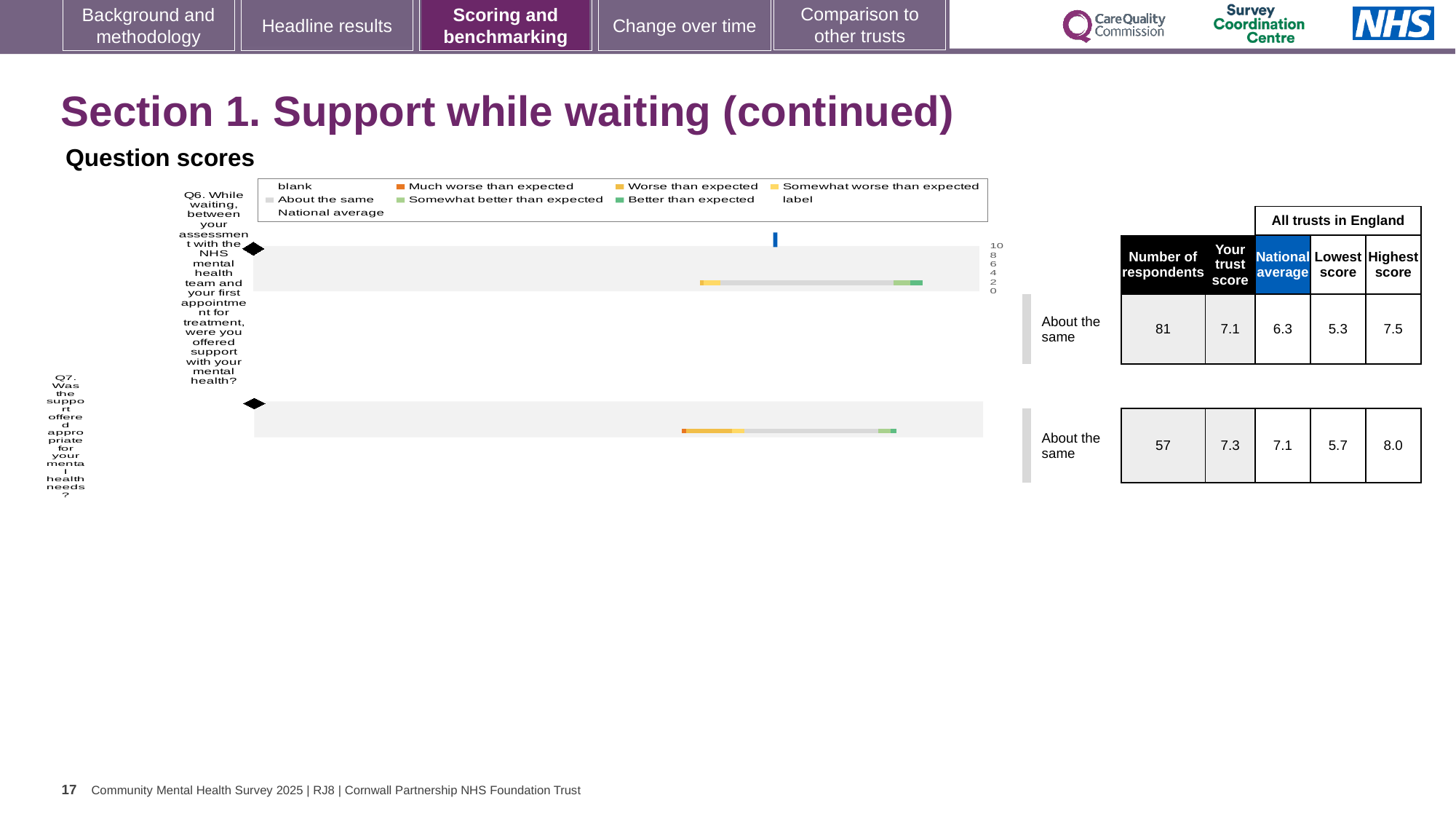
What is the national average score for Q7 (was the support offered appropriate for your mental health needs)? 7.1 How many respondents are recorded for Q6? 81 How many questions are plotted in the question scores chart? 2 What colour does the legend use for 'Much worse than expected'? Orange What kind of chart is used to show the question scores on this slide? Bar chart What is the lowest score among all trusts in England for Q7? 5.7 Which question has more respondents, Q6 or Q7? Q6 What benchmark category label is shown next to the Q6 bar? About the same What is the 'Your trust score' value for Q6 (support with your mental health while waiting)? 7.1 What is the highest score among all trusts in England for Q7? 8.0 Which question has the higher 'Your trust score', Q6 or Q7? Q7 What is the difference between the highest score and the lowest score for Q6? 2.2